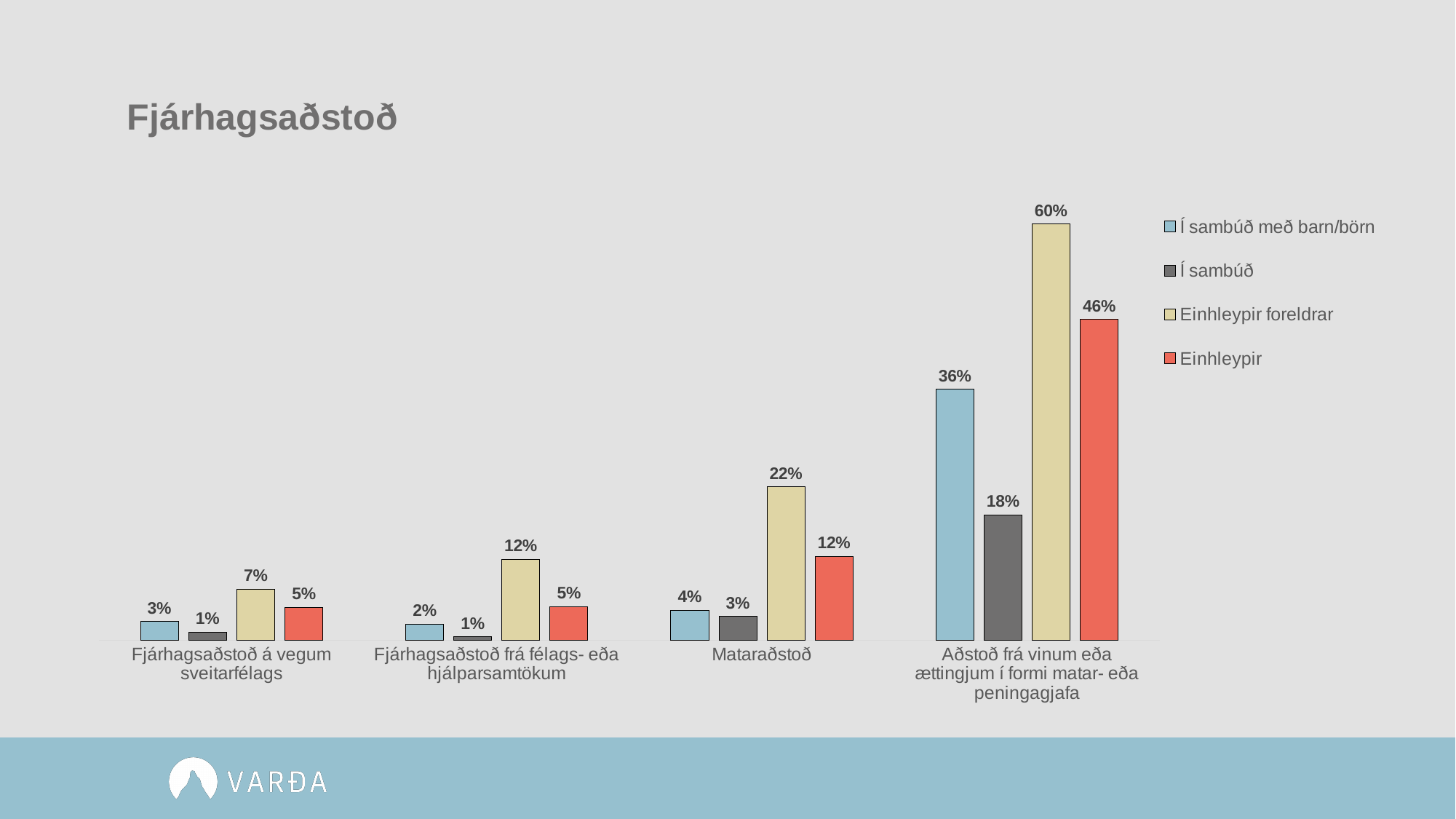
What is the title of the chart? Fjárhagsaðstoð What is the difference between the Einhleypir foreldrar and Einhleypir values in the category Aðstoð frá vinum eða ættingjum í formi matar- eða peningagjafa? 14% How many categories are shown on the x axis? 4 What is the value for Einhleypir in the category Fjárhagsaðstoð frá félags- eða hjálparsamtökum? 5% Which is larger in the category Fjárhagsaðstoð á vegum sveitarfélags: the value for Einhleypir foreldrar or the value for Einhleypir? Einhleypir foreldrar How many series does the legend list? 4 What is the value for Í sambúð með barn/börn in the category Aðstoð frá vinum eða ættingjum í formi matar- eða peningagjafa? 36% What kind of chart is shown on the slide? Bar chart Which series has the highest value in the category Aðstoð frá vinum eða ættingjum í formi matar- eða peningagjafa? Einhleypir foreldrar What is the difference between the Einhleypir foreldrar and Í sambúð values in the Mataraðstoð category? 19% Which series has the lowest value in the Mataraðstoð category? Í sambúð What is the value for Einhleypir foreldrar in the Mataraðstoð category? 22%